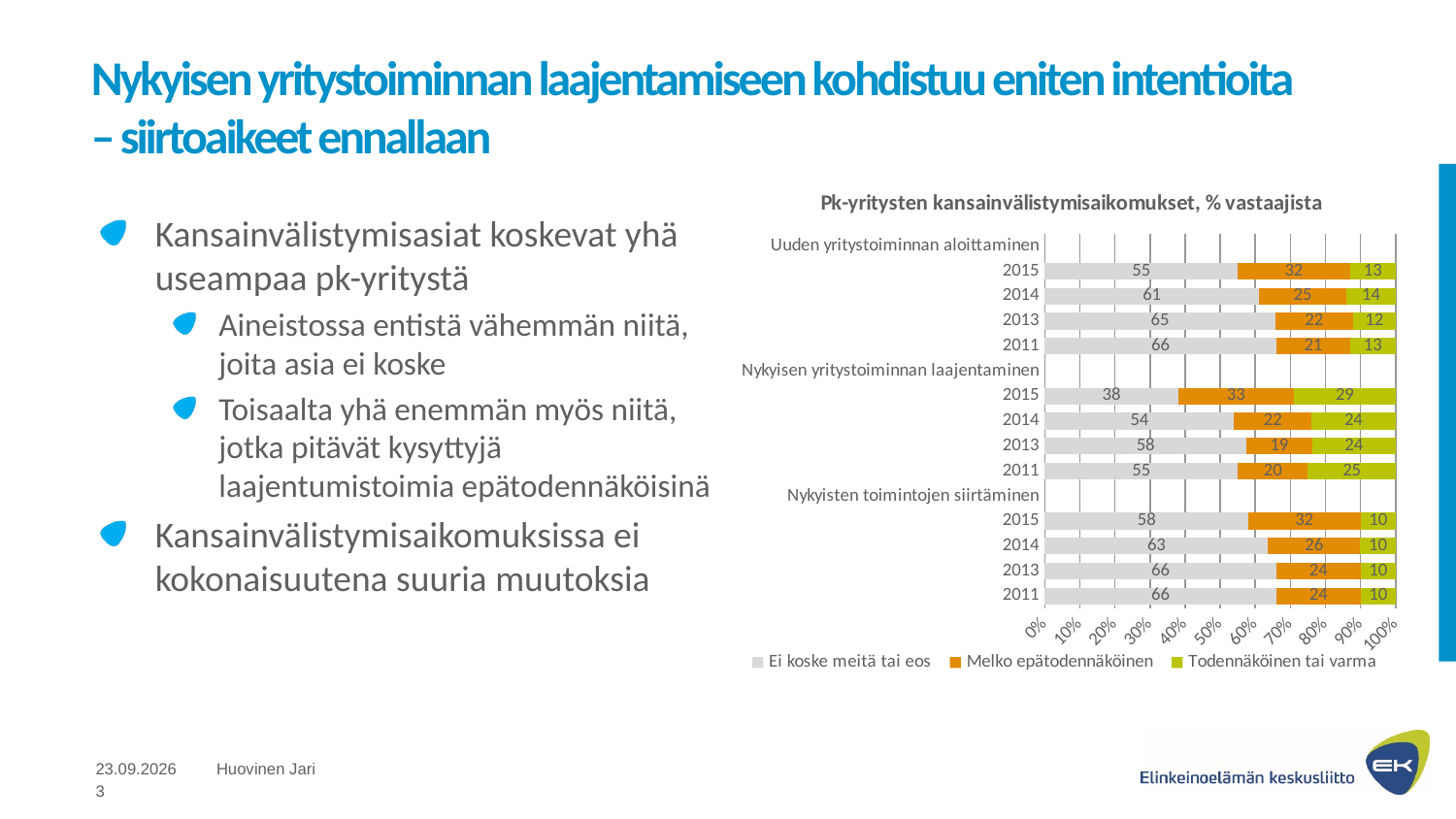
What is the title of the chart? Pk-yritysten kansainvälistymisaikomukset, % vastaajista In the group 'Uuden yritystoiminnan aloittaminen', what is the value of 'Melko epätodennäköinen' for 2014? 25 In the group 'Uuden yritystoiminnan aloittaminen', which year has the lowest value for 'Ei koske meitä tai eos'? 2015 In the group 'Nykyisen yritystoiminnan laajentaminen', which year has the highest value for 'Todennäköinen tai varma'? 2015 In the group 'Nykyisten toimintojen siirtäminen', what is the value of 'Todennäköinen tai varma' for 2013? 10 In the group 'Nykyisten toimintojen siirtäminen', what is the difference between the 'Melko epätodennäköinen' values for 2015 and 2011? 8 How many series does the chart legend list? 3 In the group 'Nykyisen yritystoiminnan laajentaminen', which is larger: the 'Melko epätodennäköinen' value for 2015 or for 2014? 2015 How many year bars are shown in the group 'Nykyisten toimintojen siirtäminen'? 4 In the group 'Nykyisen yritystoiminnan laajentaminen', what is the value of 'Ei koske meitä tai eos' for 2015? 38 What is the total of the stacked bar for 2015 in the group 'Nykyisen yritystoiminnan laajentaminen'? 100 What kind of chart is shown on the slide? stacked bar chart